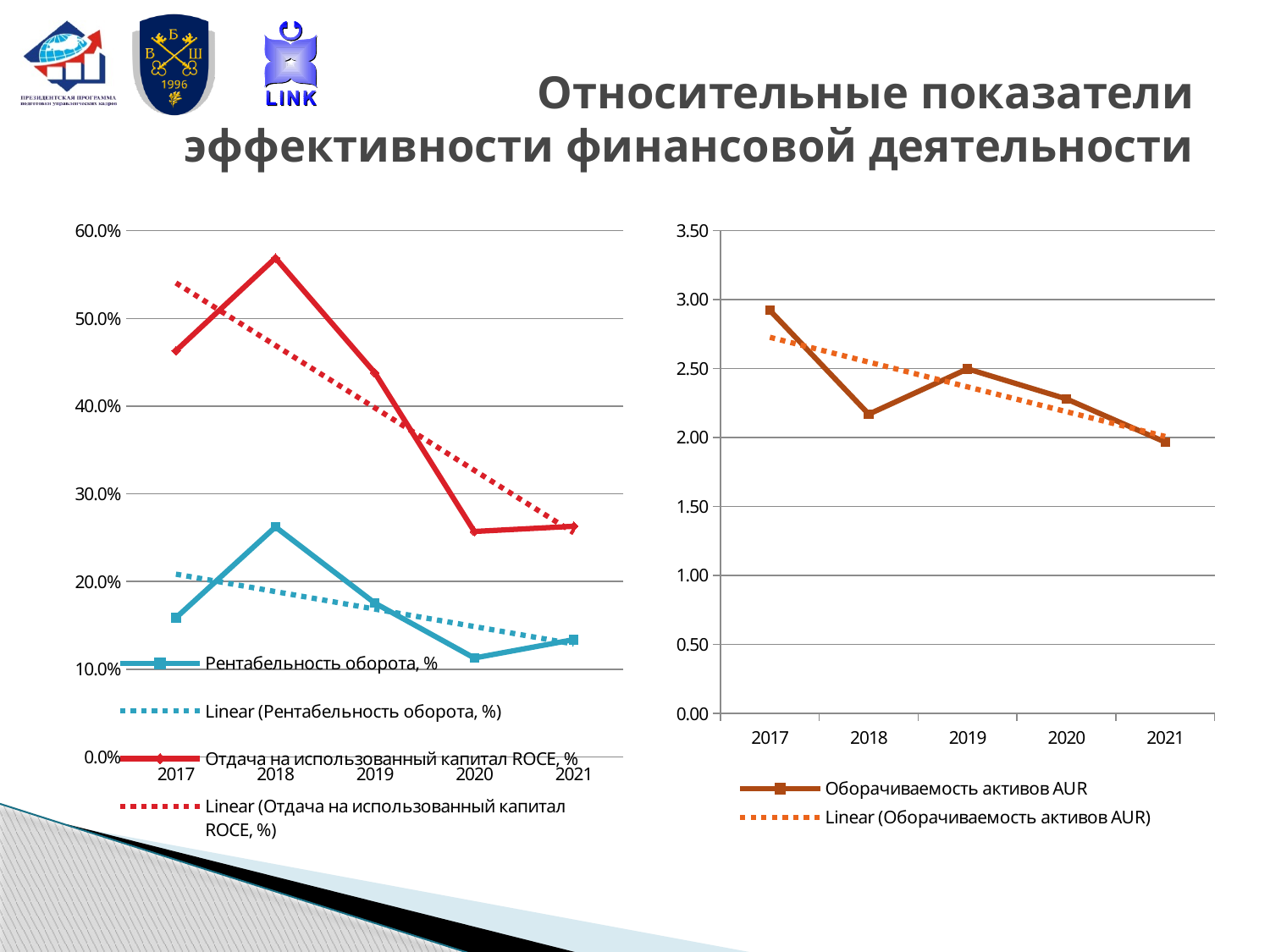
How many years are plotted on the x axis of the right chart? 5 In the left chart, in which year is the value of 'Отдача на использованный капитал ROCE, %' highest? 2018 What kind of chart is the left chart on the slide? line chart In the left chart, is the value of 'Рентабельность оборота, %' for 2020 greater or less than 20.0%? less In the left chart, in which year is the value of 'Рентабельность оборота, %' highest? 2018 How many entries does the legend of the left chart list? 4 In the left chart, is the value of 'Отдача на использованный капитал ROCE, %' for 2018 greater or less than 50.0%? greater In the right chart, in which year is 'Оборачиваемость активов AUR' lowest? 2021 In the right chart, is the value of 'Оборачиваемость активов AUR' for 2017 greater or less than 2.50? greater In the right chart, does the dotted linear trend line for 'Оборачиваемость активов AUR' rise or fall from 2017 to 2021? fall In the right chart, in which year is 'Оборачиваемость активов AUR' highest? 2017 How many entries does the legend of the right chart list? 2